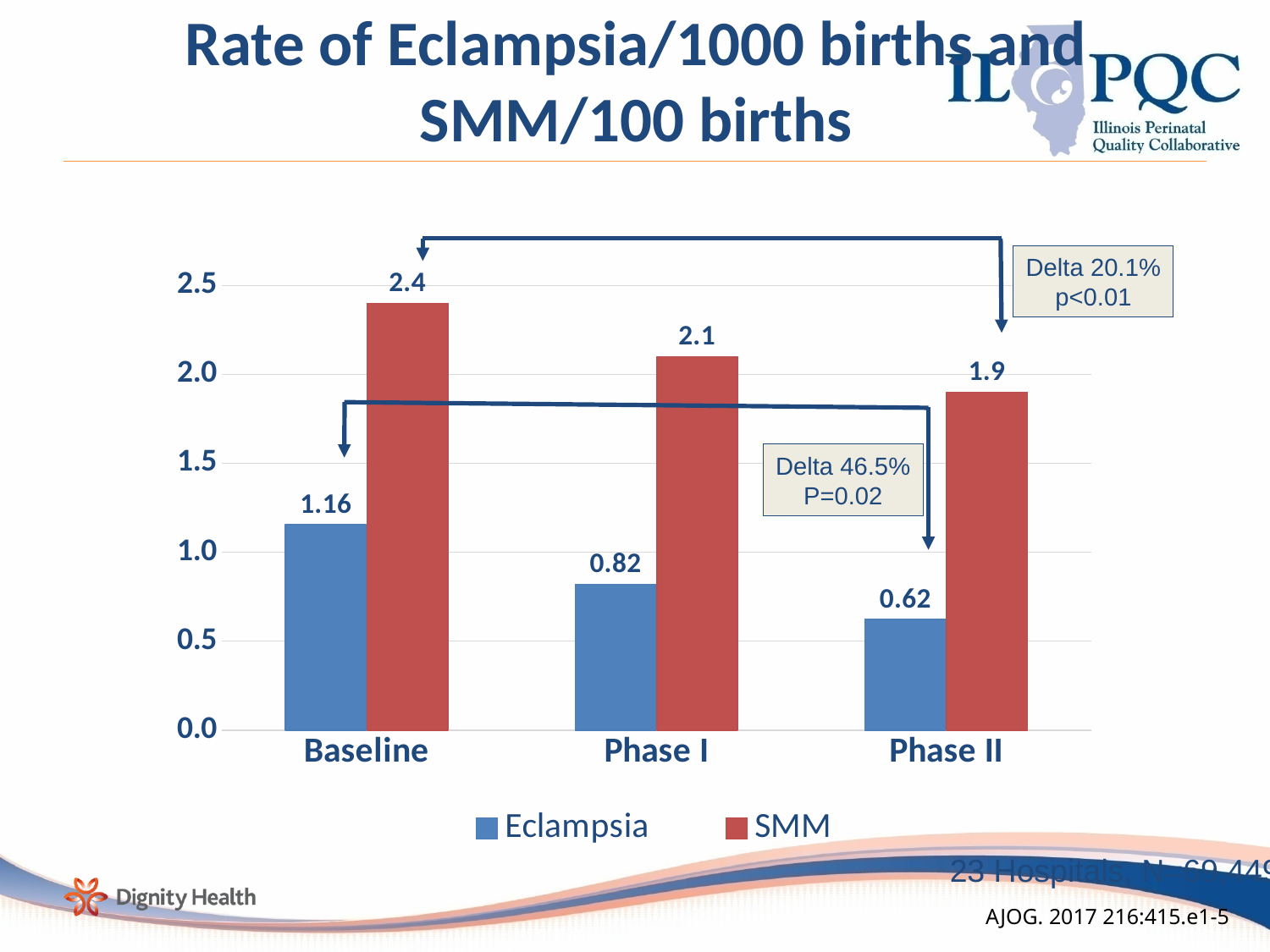
What is the Eclampsia value for Phase II? 0.62 Which category has the lowest Eclampsia value? Phase II What is the Eclampsia value for Baseline? 1.16 Which is larger, the Eclampsia value for Phase I or the Eclampsia value for Phase II? Phase I How many series does the legend list? 2 What is the SMM value for Phase II? 1.9 What is the difference between the Eclampsia values for Baseline and Phase II? 0.54 What is the SMM value for Phase I? 2.1 Do the SMM values rise or fall from Baseline to Phase II? fall How many categories are shown on the x axis? 3 What is the difference between the SMM values for Baseline and Phase II? 0.5 Which category has the highest SMM value? Baseline